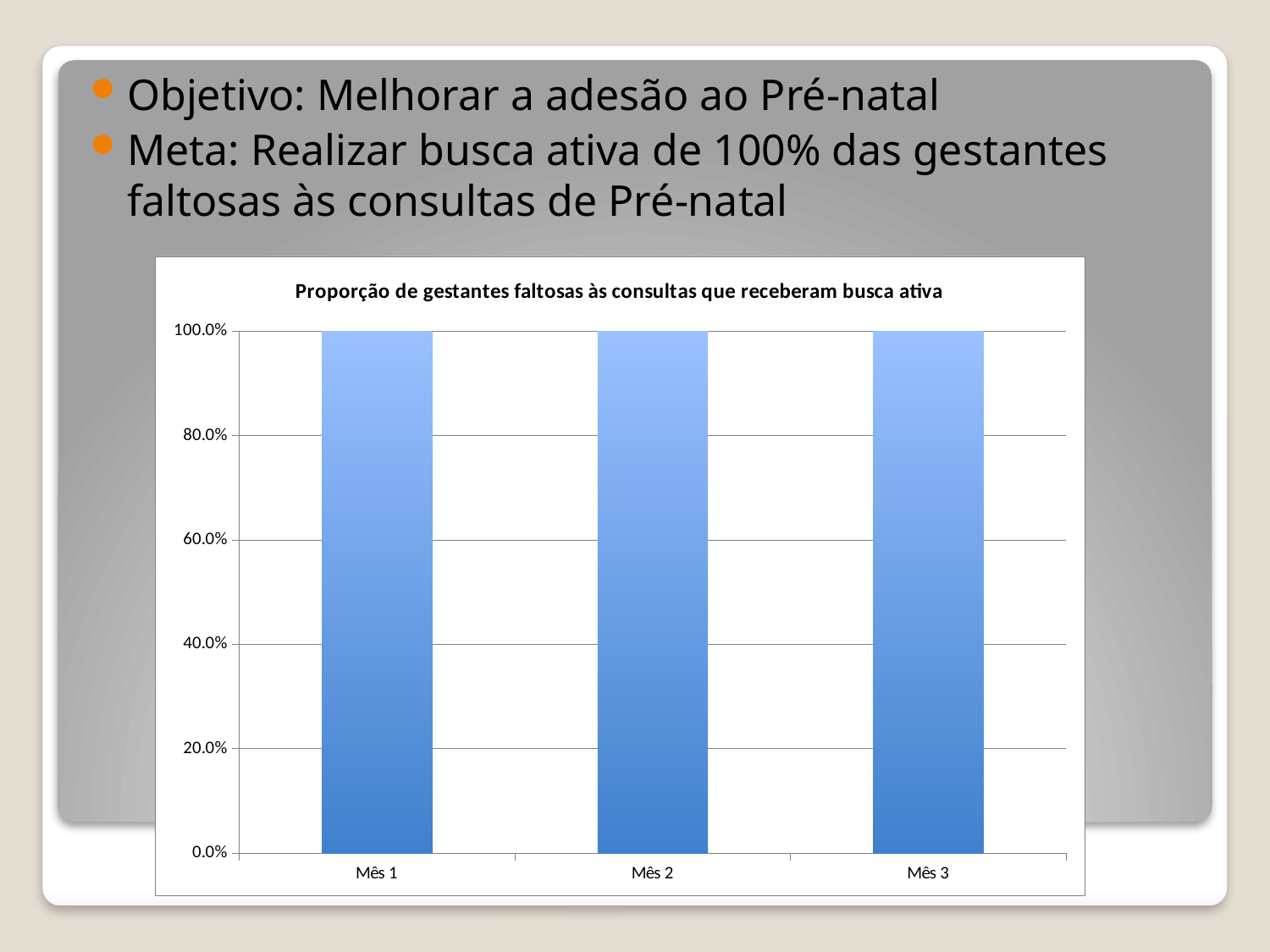
What is the value for Mês 3? 100.0% What is the value for Mês 2? 100.0% What is the value for Mês 1? 100.0% What is the difference between the values for Mês 1 and Mês 3? 0.0% What is the title of the chart? Proporção de gestantes faltosas às consultas que receberam busca ativa How many categories are shown on the x axis of the chart? 3 Is the value for Mês 3 greater or less than 60.0%? greater Do the values rise, fall, or stay the same from Mês 1 to Mês 3? stay the same What is the highest value shown on the y axis of the chart? 100.0% What type of chart is shown on the slide? bar chart Is the value for Mês 2 greater or less than 80.0%? greater